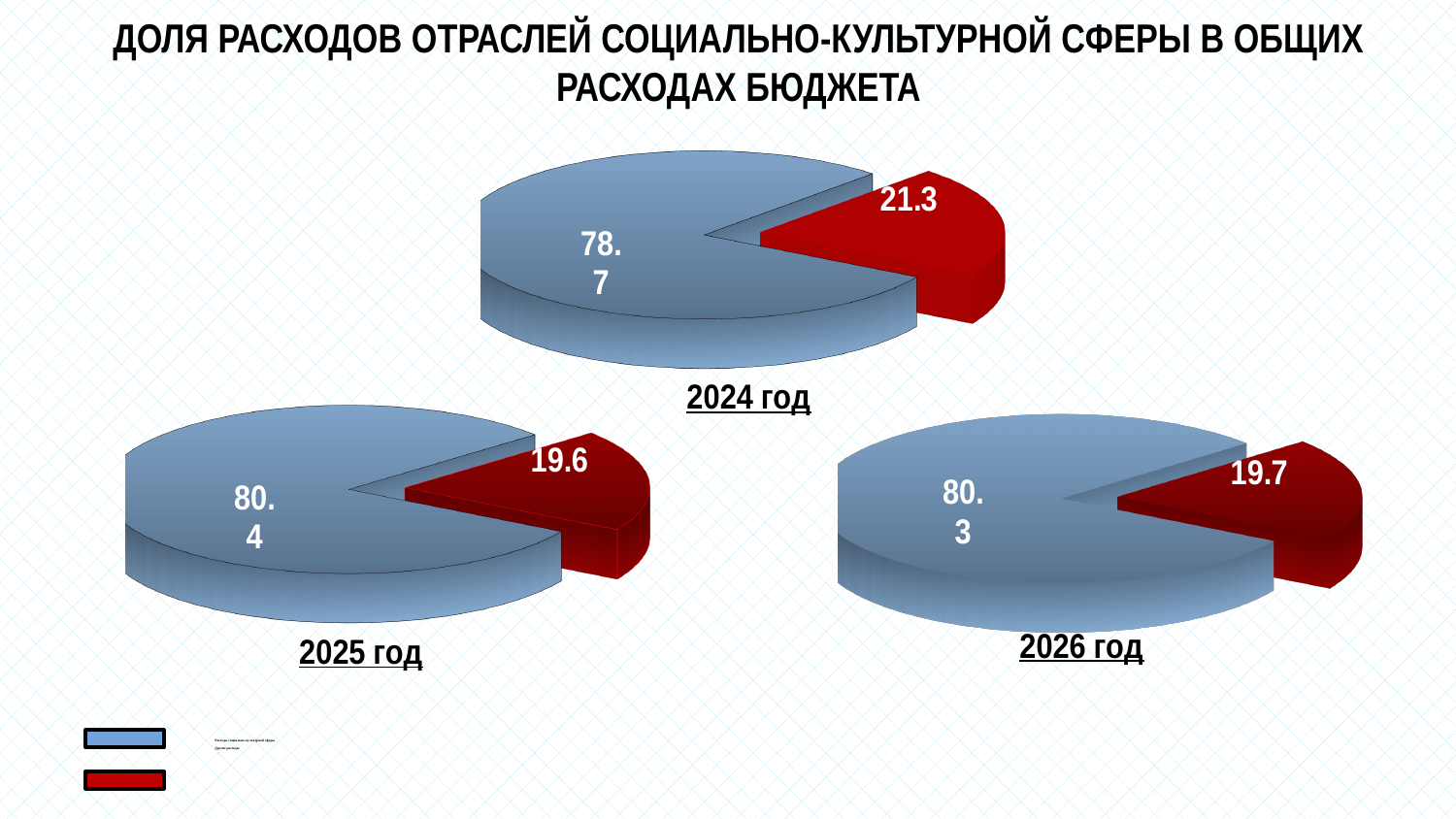
In the 2026 год chart, what value is shown on the blue slice? 80.3 In the 2026 год chart, what value is shown on the red slice? 19.7 In the 2024 год chart, what is the difference between the blue slice value and the red slice value? 57.4 In the 2025 год chart, what value is shown on the red slice? 19.6 In the 2025 год chart, what value is shown on the blue slice? 80.4 In the 2024 год chart, what value is shown on the red slice? 21.3 How many pie charts are shown on the slide? 3 In the 2024 год chart, which slice is larger, the blue one or the red one? the blue one What kind of chart is used for the 2024 год chart? pie chart How many slices does the 2025 год pie chart have? 2 In the 2024 год chart, what value is shown on the blue slice? 78.7 Which year's chart has the largest red slice value: 2024, 2025 or 2026? 2024 год